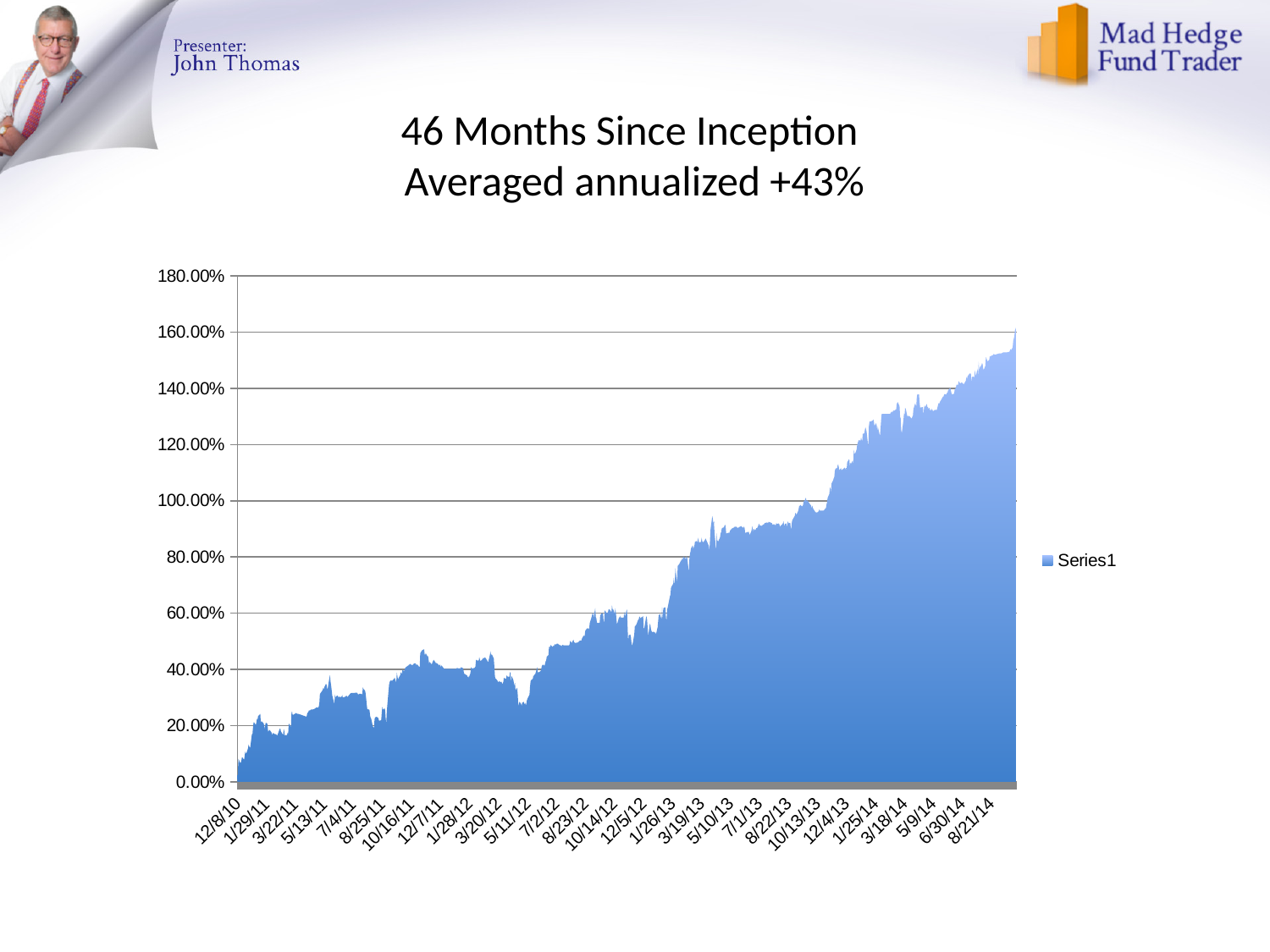
Which date has the larger value, 12/8/10 or 8/21/14? 8/21/14 How many series does the chart legend list? 1 Is the value at 12/8/10 greater or less than 20.00%? less Which date has the larger value, 5/11/12 or 7/1/13? 7/1/13 Is the value at 7/1/13 greater or less than 80.00%? greater What is the highest value shown on the chart's vertical axis? 180.00% Do the values generally rise or fall from 12/8/10 to 8/21/14? rise Is the value at 12/4/13 greater or less than 100.00%? greater What kind of chart is shown on the slide? area chart What is the name of the series shown in the chart legend? Series1